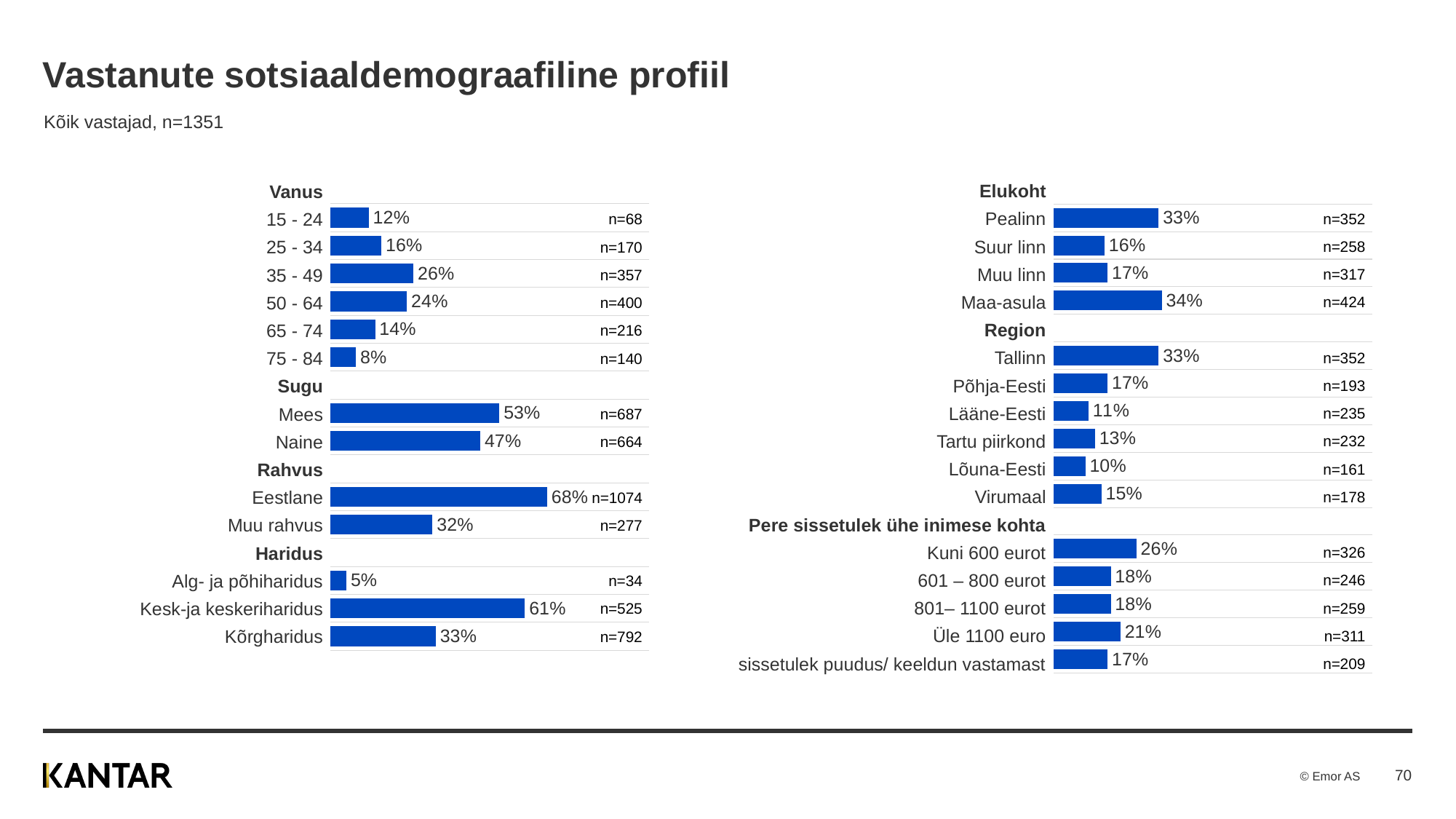
In the right chart, what is the value for Lõuna-Eesti? 10% In the right chart, which category under Region has the highest value? Tallinn In the left chart, what is the value for the 35 - 49 age group? 26% In the right chart, how many categories are listed under Pere sissetulek ühe inimese kohta? 5 In the right chart, what is the difference between the values for Pealinn and Suur linn? 17% In the left chart, which age group under Vanus has the lowest value? 75 - 84 In the left chart, what is the value for Kõrgharidus? 33% What type of chart is used on this slide? Bar chart In the right chart, what is the value for Maa-asula? 34% In the left chart, which is larger, the value for Eestlane or Muu rahvus? Eestlane In the left chart, what is the difference between the values for Mees and Naine? 6% In the left chart, what is the sample size (n) shown for Kesk-ja keskeriharidus? n=525